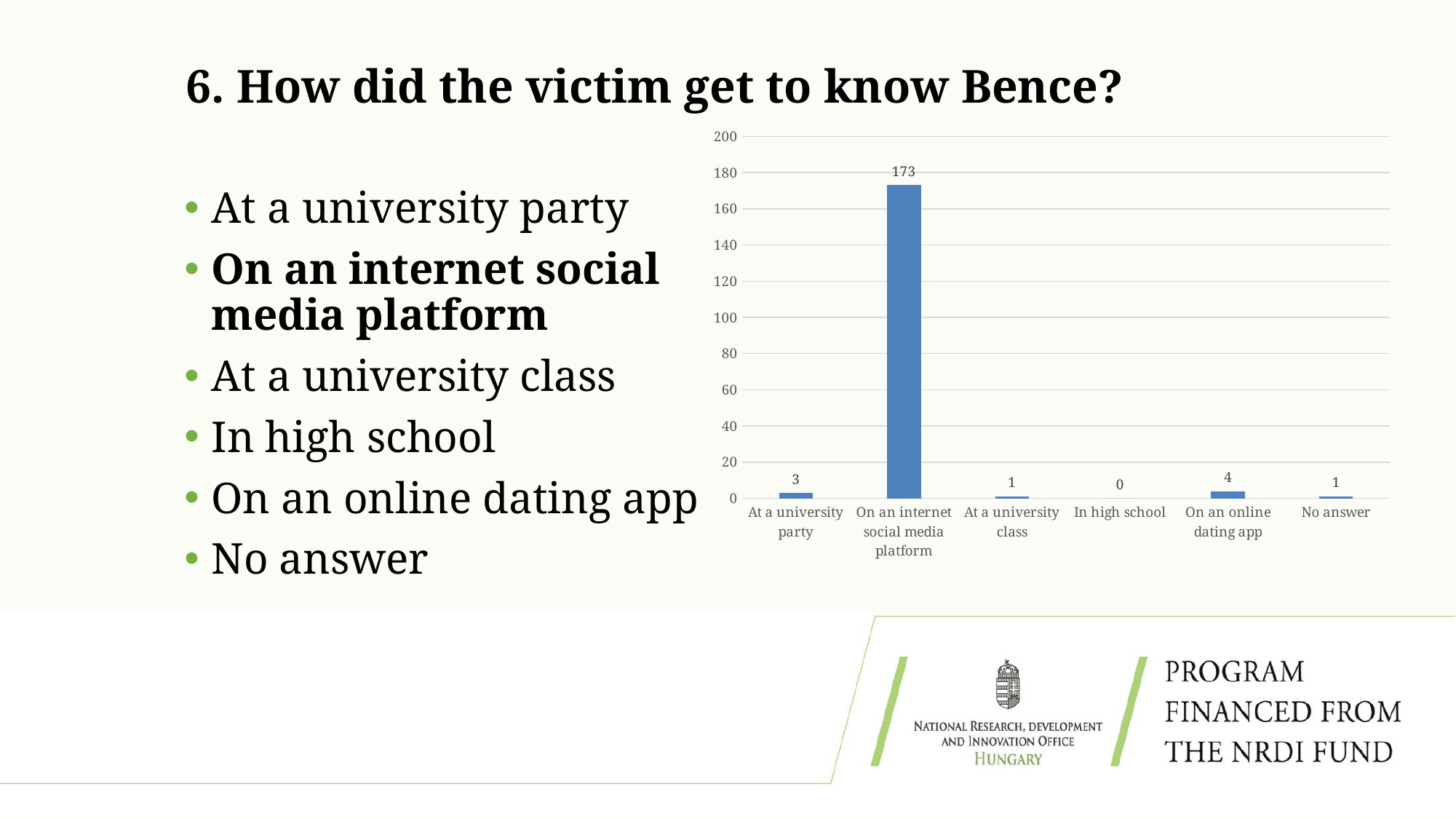
What is the value for "On an online dating app"? 4 Which is larger, the value for "At a university party" or the value for "On an online dating app"? On an online dating app What is the value for "On an internet social media platform"? 173 Is the value for "On an internet social media platform" greater or less than 160? greater How many categories are shown on the x axis of the chart? 6 What is the value for "At a university party"? 3 Which category has the highest value? On an internet social media platform What is the value for "No answer"? 1 Which category has the lowest value? In high school What kind of chart is shown on the slide? Bar chart What is the value for "In high school"? 0 What is the difference between the values for "On an internet social media platform" and "On an online dating app"? 169